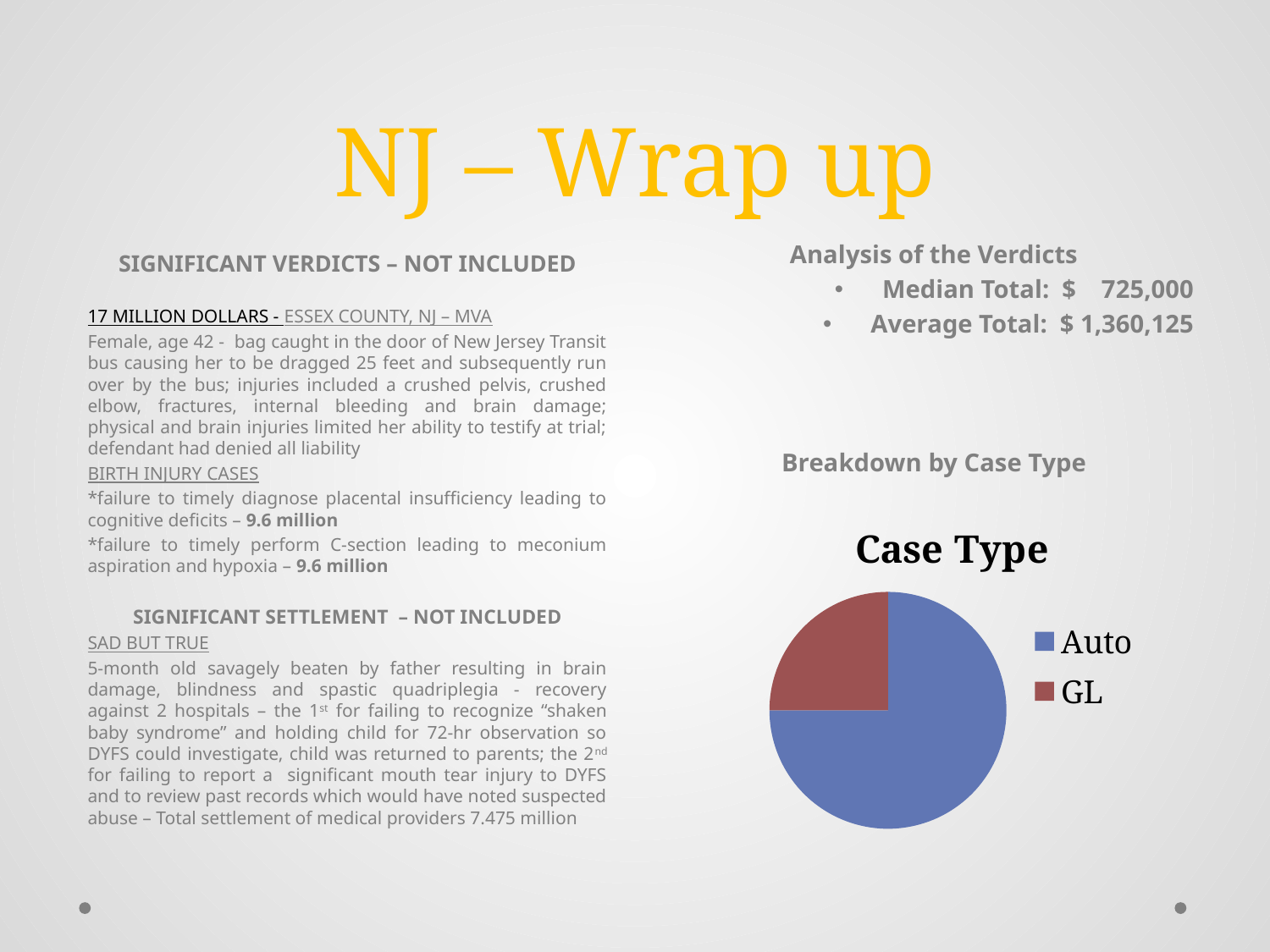
Which case type has the largest slice in the Case Type pie chart? Auto What is the title of the pie chart? Case Type In the Case Type pie chart, which slice is larger, Auto or GL? Auto How many slices does the Case Type pie chart have? 2 How many entries does the legend of the Case Type pie chart list? 2 What kind of chart is shown on the slide? pie chart Which case type has the smallest slice in the Case Type pie chart? GL What colour represents Auto in the Case Type pie chart? blue